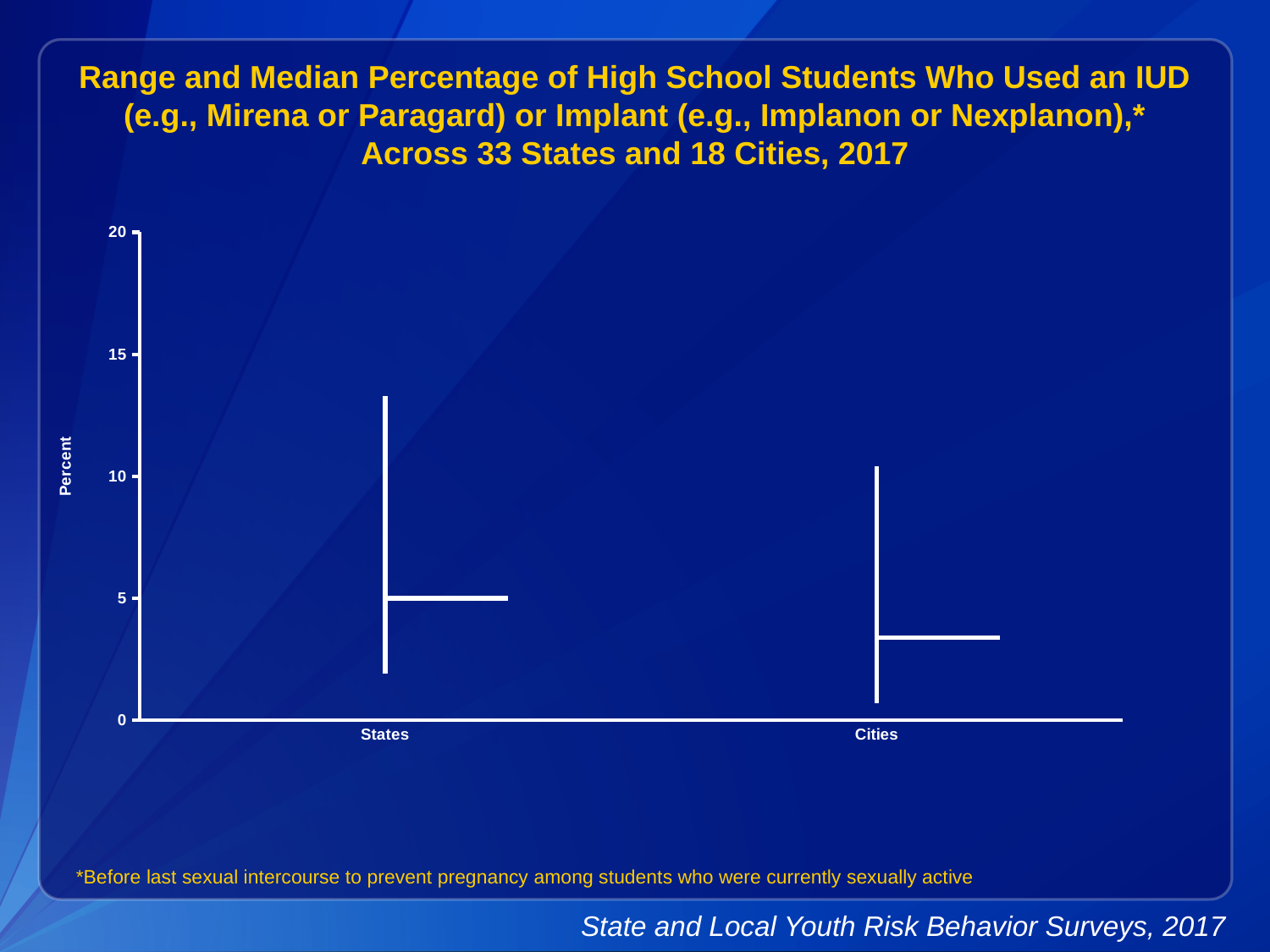
What are the two categories shown on the x axis? States and Cities What is the highest value shown on the y axis of the chart? 20 Which category has the higher median percentage, States or Cities? States How many categories are shown on the x axis of the chart? 2 Which category has the higher upper end of its range, States or Cities? States Is the median value for Cities greater or less than 5? less Is the lower end of the range for States greater or less than 5? less Which category has the lower median percentage? Cities Is the upper end of the range for Cities greater or less than 15? less What is the label on the y axis of the chart? Percent